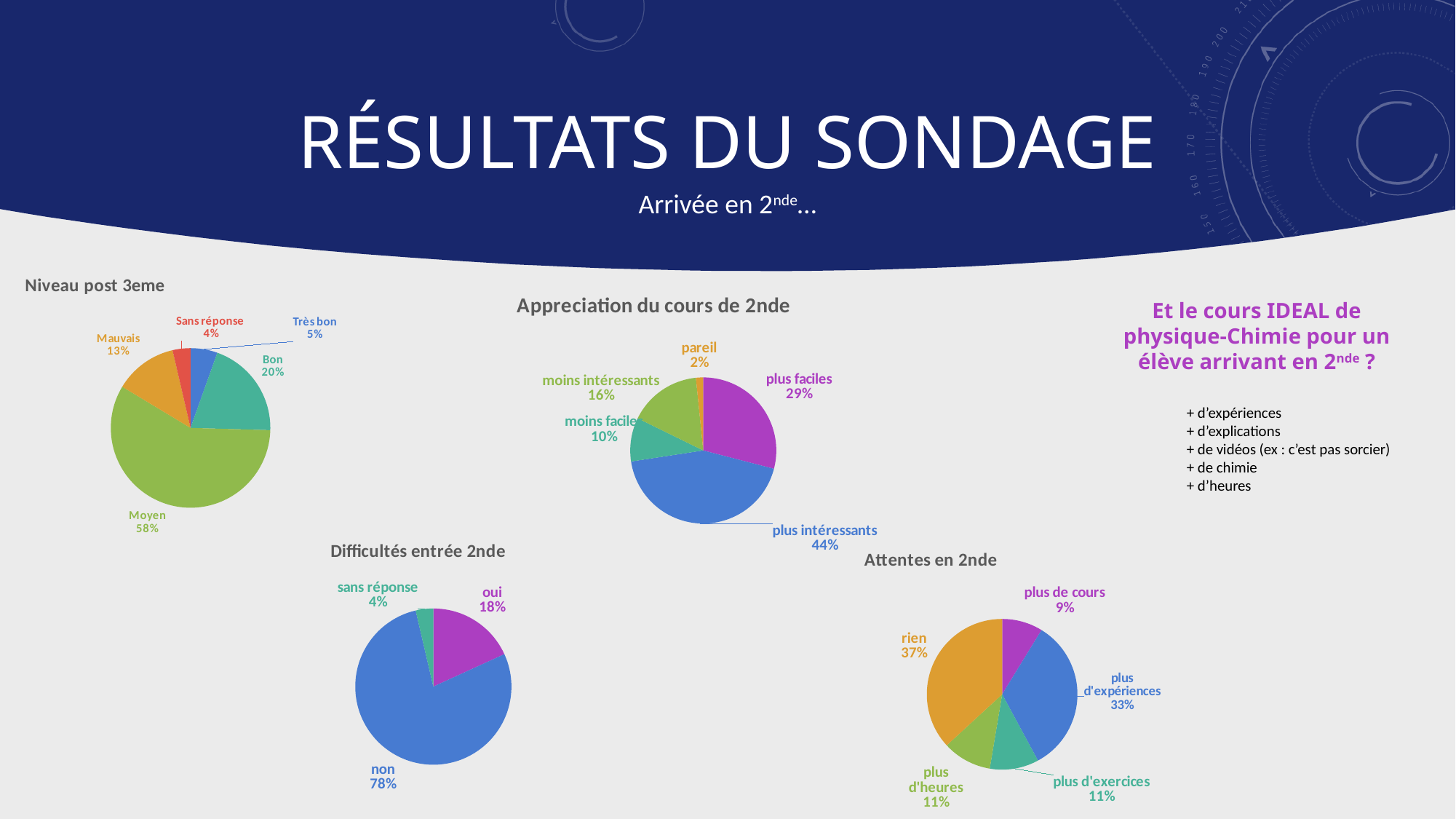
In the 'Appreciation du cours de 2nde' chart, which is larger: 'moins intéressants' or 'moins faciles'? moins intéressants How many slices does the 'Appreciation du cours de 2nde' chart have? 5 What type of chart is 'Attentes en 2nde'? Pie chart In the 'Niveau post 3eme' chart, which category has the smallest share? Sans réponse In the 'Difficultés entrée 2nde' chart, what share is labelled for 'non'? 78% In the 'Attentes en 2nde' chart, what share is labelled for 'plus d'expériences'? 33% In the 'Niveau post 3eme' chart, what share is labelled for 'Moyen'? 58% In the 'Attentes en 2nde' chart, which category has the largest share? rien In the 'Niveau post 3eme' chart, what is the difference between the 'Bon' and 'Mauvais' shares? 7% In the 'Appreciation du cours de 2nde' chart, what share is labelled for 'plus intéressants'? 44% How many pie charts are shown on the slide? 4 In the 'Difficultés entrée 2nde' chart, what is the difference between the 'non' and 'oui' shares? 60%